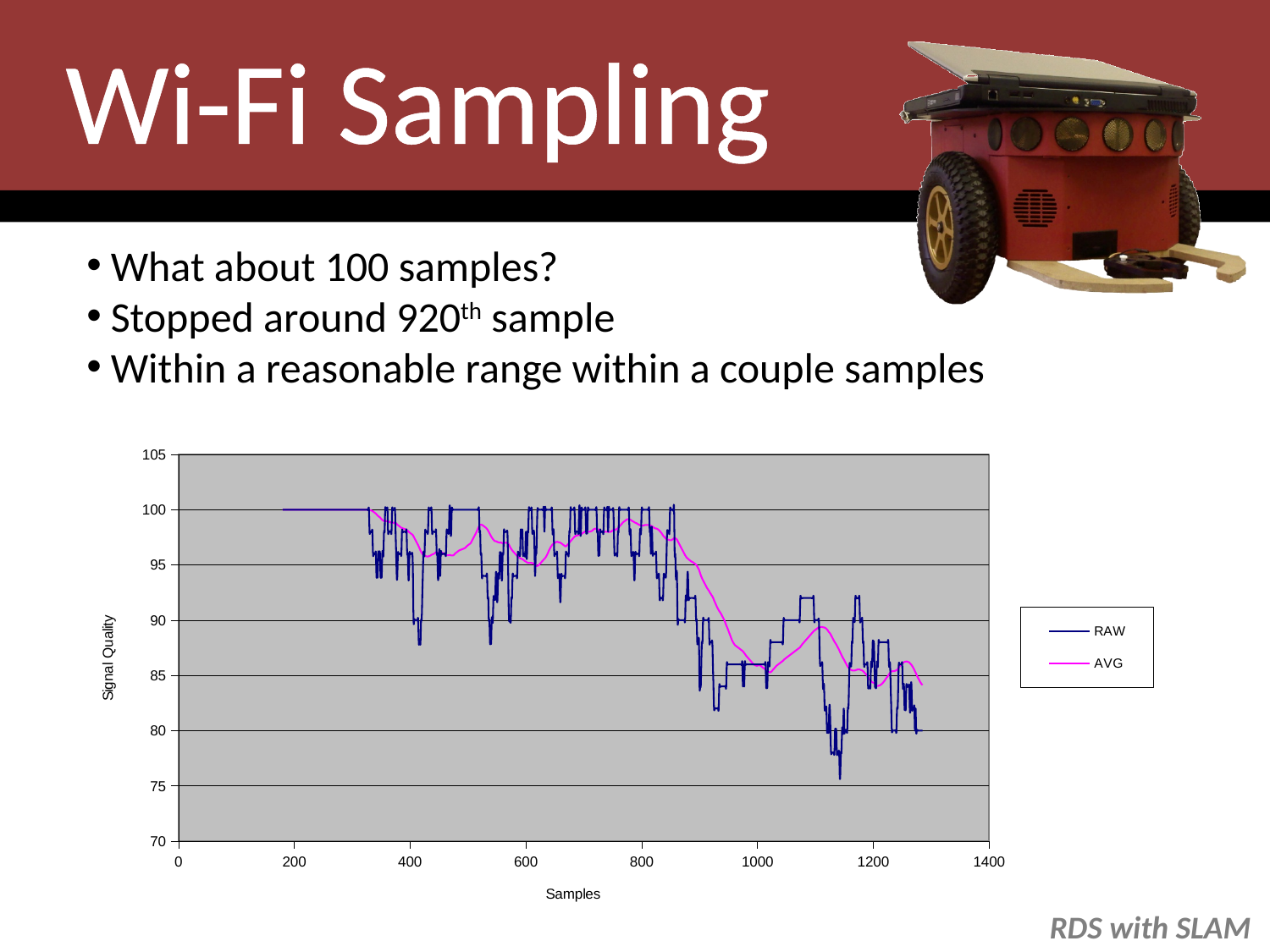
Is the RAW signal quality at sample 200 greater or less than 95? greater Around sample 1150, which series has the larger signal quality value, RAW or AVG? AVG Overall, does the signal quality rise or fall as the number of samples increases? fall What is the highest value shown on the chart's vertical axis? 105 How many series does the chart's legend list? 2 Is the AVG signal quality at sample 600 greater or less than 90? greater What is the label of the chart's vertical axis? Signal Quality What are the two series named in the chart's legend? RAW and AVG Is the AVG signal quality at sample 1000 greater or less than 90? less What kind of chart is shown on the slide? line chart